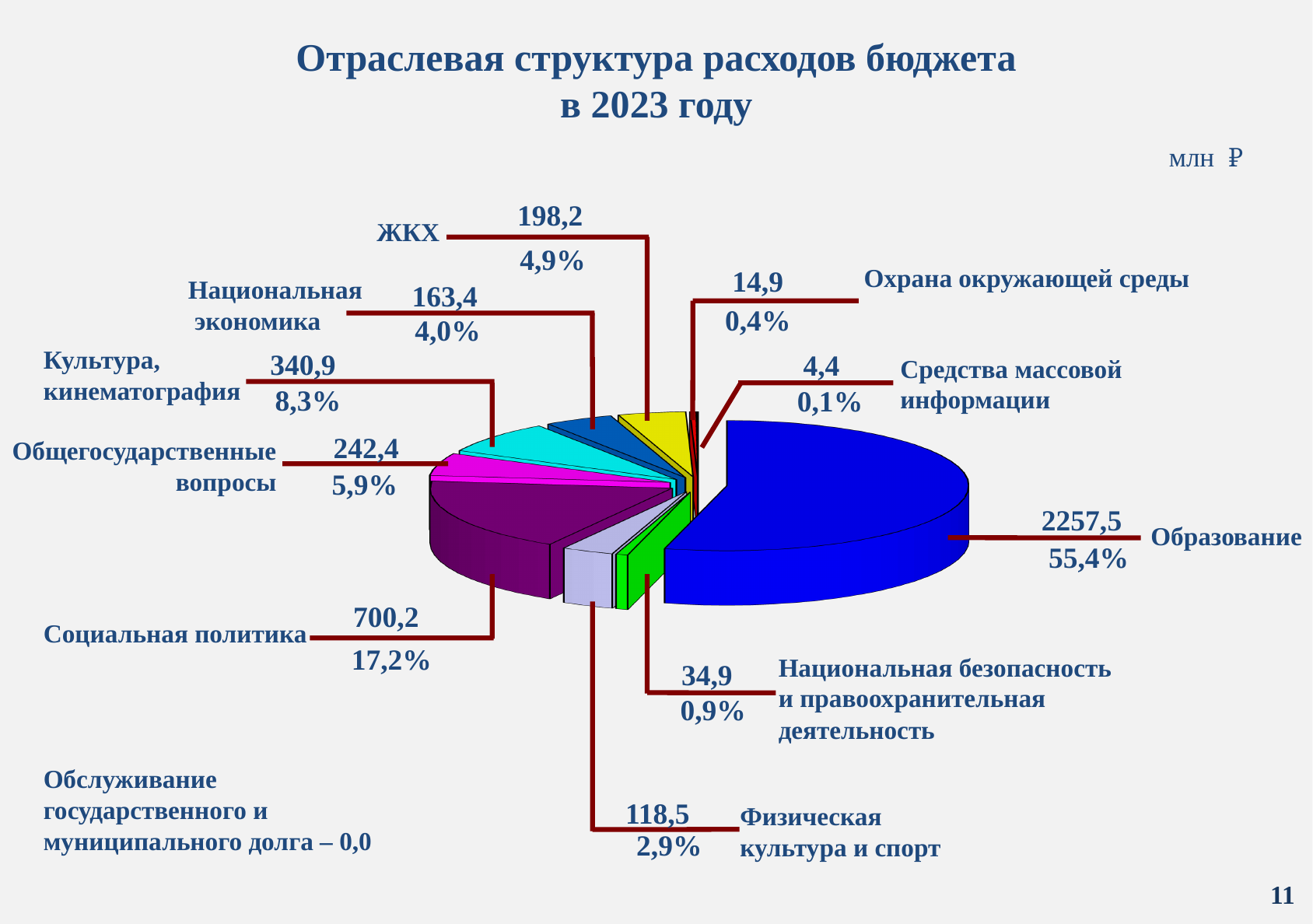
What share of the pie does Физическая культура и спорт take? 2,9% What kind of chart is shown on the slide? pie chart Which category has the largest slice of the pie? Образование What is the value for Образование? 2257,5 What share of the pie does Образование take? 55,4% Which is larger, the value for ЖКХ or the value for Национальная экономика? ЖКХ In what units are the values on the chart given? млн ₽ What is the difference in percentage share between Образование and Социальная политика? 38,2% Which labelled slice of the pie has the smallest value? Средства массовой информации What is the difference between the values for Социальная политика and Культура, кинематография? 359,3 What is the value for Социальная политика? 700,2 What is the value for Охрана окружающей среды? 14,9